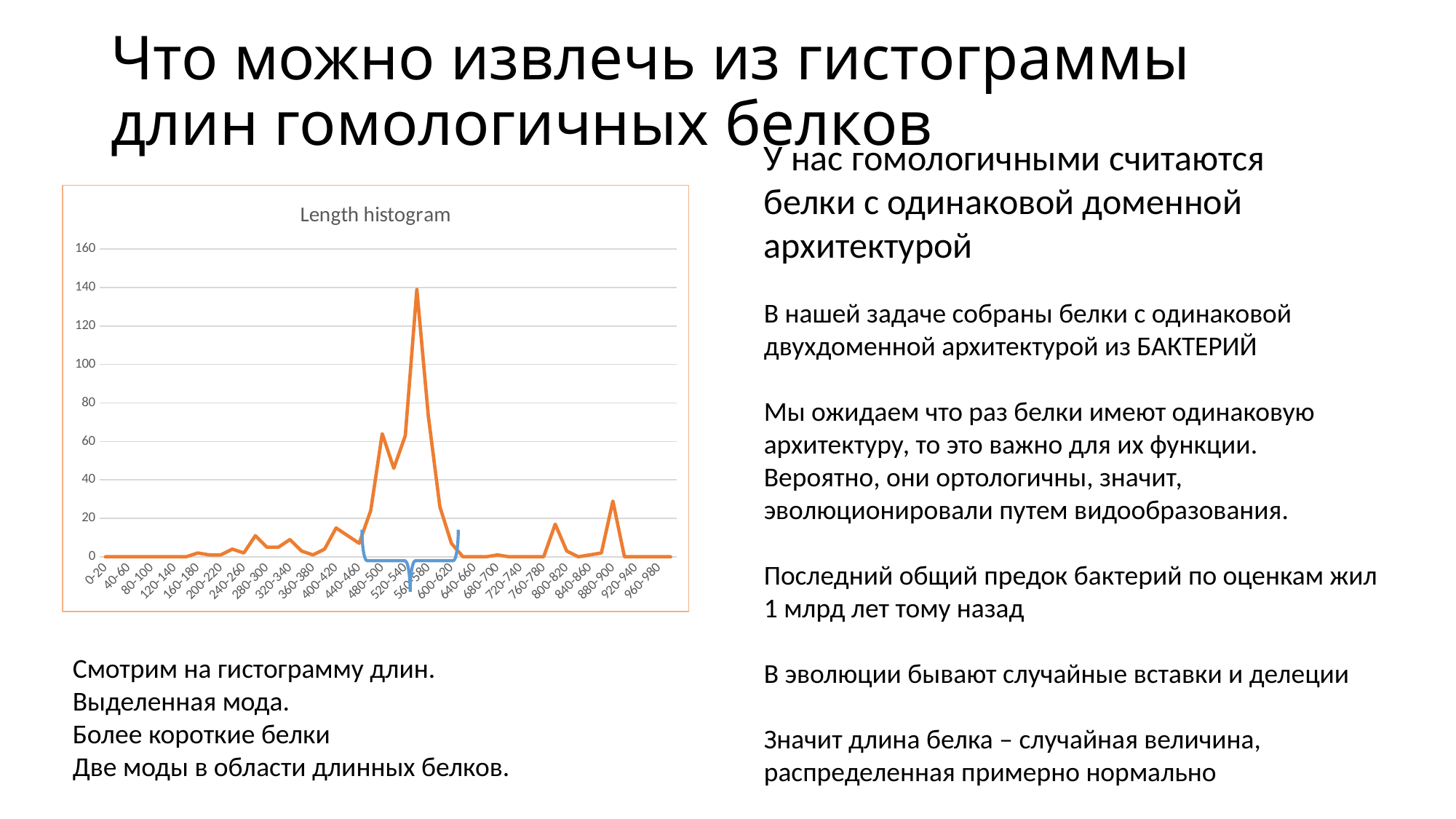
In the "Length histogram" chart, is the value for 560-580 greater or less than 120? less What kind of chart is the "Length histogram" chart? line chart What is the title of the chart on the slide? Length histogram What colour is the line in the "Length histogram" chart? orange In the "Length histogram" chart, is the value for 880-900 greater or less than 20? greater In the "Length histogram" chart, which has the larger value: 560-580 or 480-500? 560-580 In the "Length histogram" chart, is the value for 880-900 greater or less than 40? less In the "Length histogram" chart, do the values rise or fall from 560-580 to 640-660? fall In the "Length histogram" chart, which has the larger value: 480-500 or 880-900? 480-500